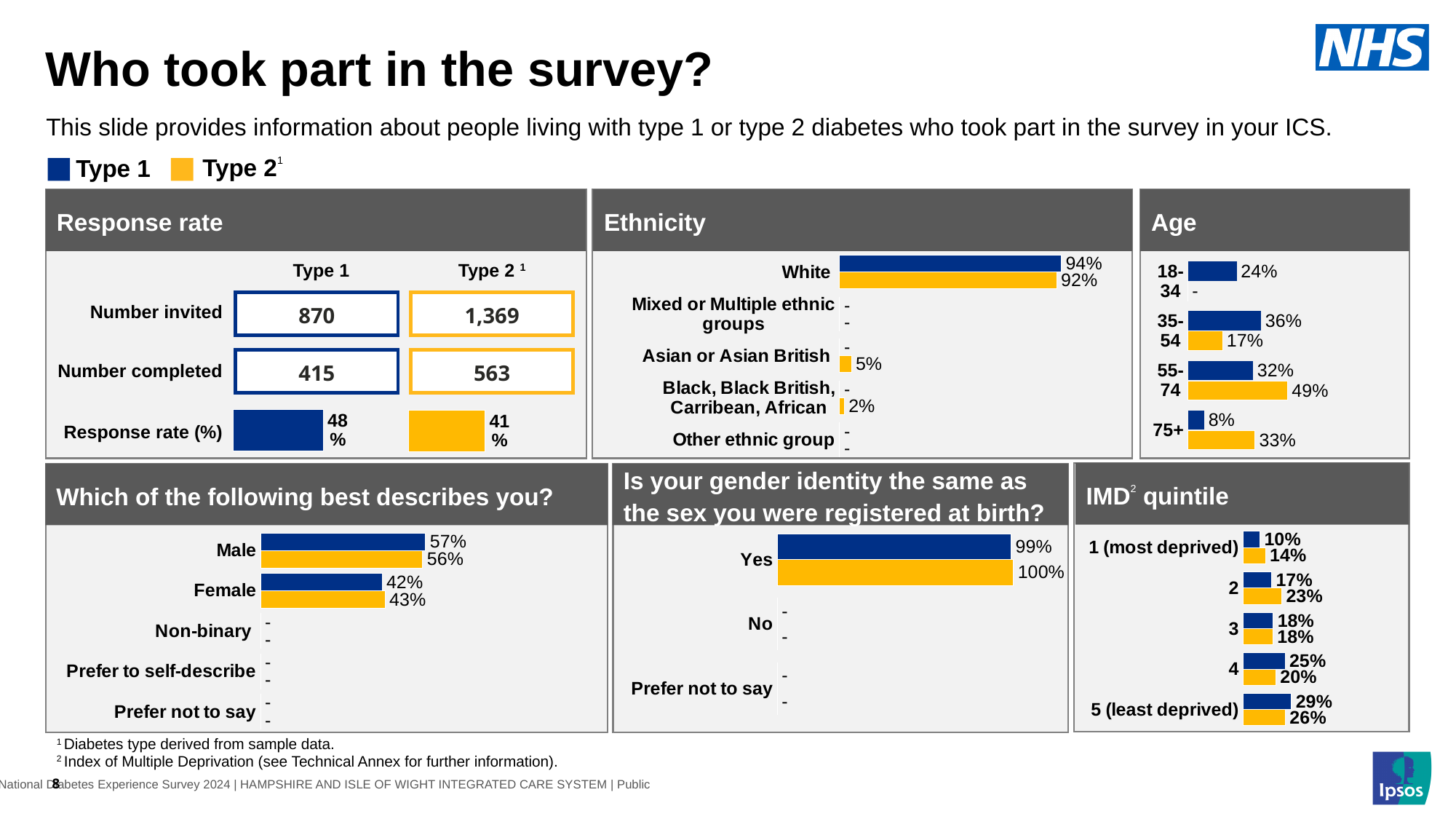
In the gender identity chart, what percentage of Type 2 respondents answered Yes? 100% In the Response rate panel, what is the difference between the number invited for Type 2 and Type 1? 499 In the Age chart, which age group has the lowest Type 1 percentage? 75+ In the IMD quintile chart, what is the Type 2 percentage for quintile 2? 23% In the 'Which of the following best describes you?' chart, is the Type 1 or Type 2 percentage larger for Male? Type 1 In the Age chart, what percentage of Type 2 respondents are aged 55-74? 49% In the IMD quintile chart, what is the difference between the Type 1 and Type 2 percentages for quintile 4? 5% What kind of chart is the Age chart? Bar chart How many series does the legend at the top of the slide list? 2 In the Age chart, which age group has the highest Type 1 percentage? 35-54 In the Ethnicity chart, what percentage of Type 1 respondents are White? 94% In the IMD quintile chart, which quintile has the highest Type 1 percentage? 5 (least deprived)